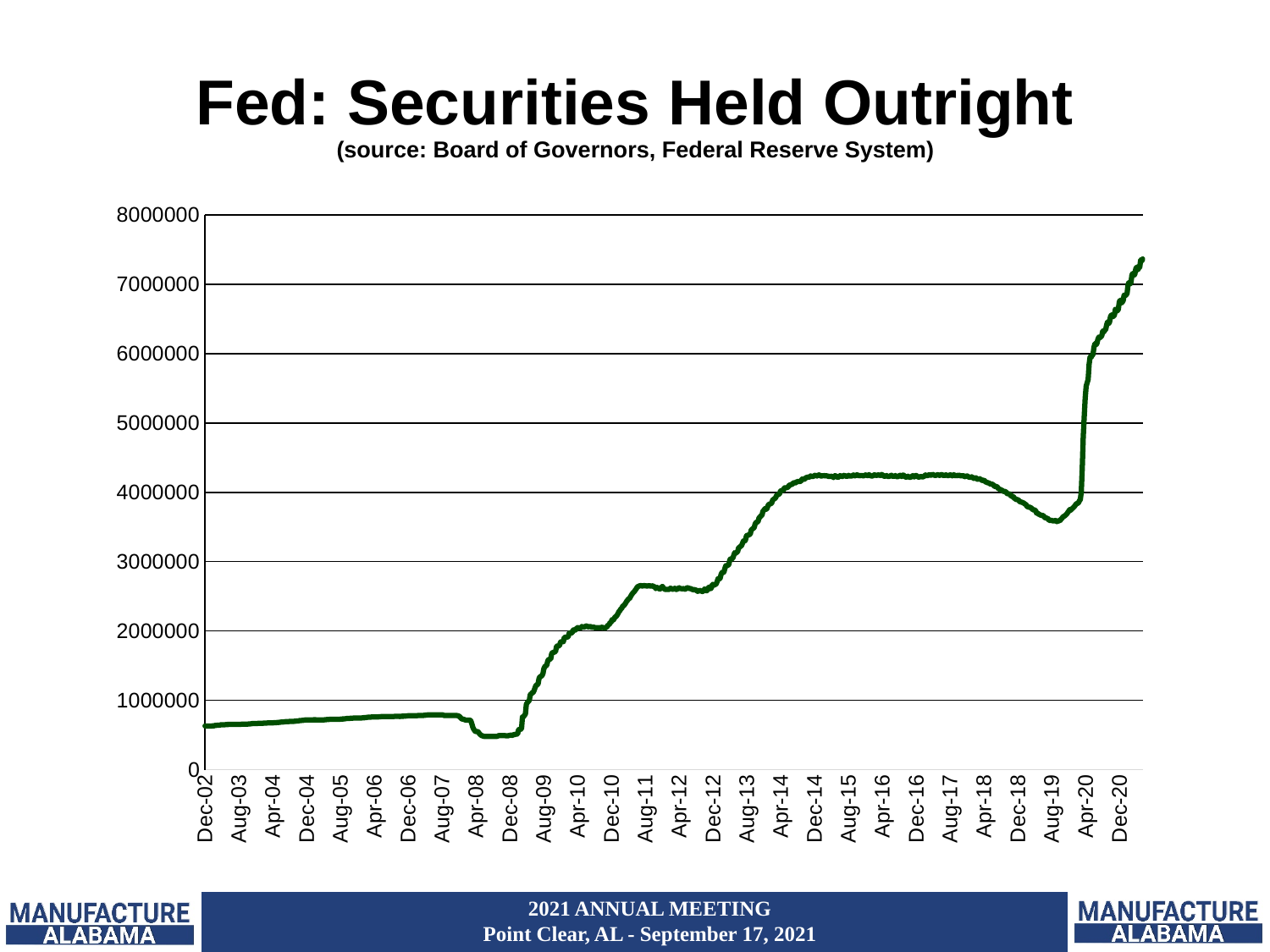
Is the value at Dec-02 greater or less than 1000000? less Is the value at Dec-20 greater or less than 7000000? less Is the value at Aug-11 greater or less than 2000000? greater Which is larger, the value at Dec-20 or the value at Dec-14? Dec-20 At which labeled date on the x axis does the line reach its highest value? Dec-20 What source is cited under the chart title? Board of Governors, Federal Reserve System What is the title of the chart? Fed: Securities Held Outright Which is larger, the value at Dec-14 or the value at Aug-19? Dec-14 Overall, does the line rise or fall from Dec-02 to Dec-20? rise What kind of chart is shown on the slide? line chart